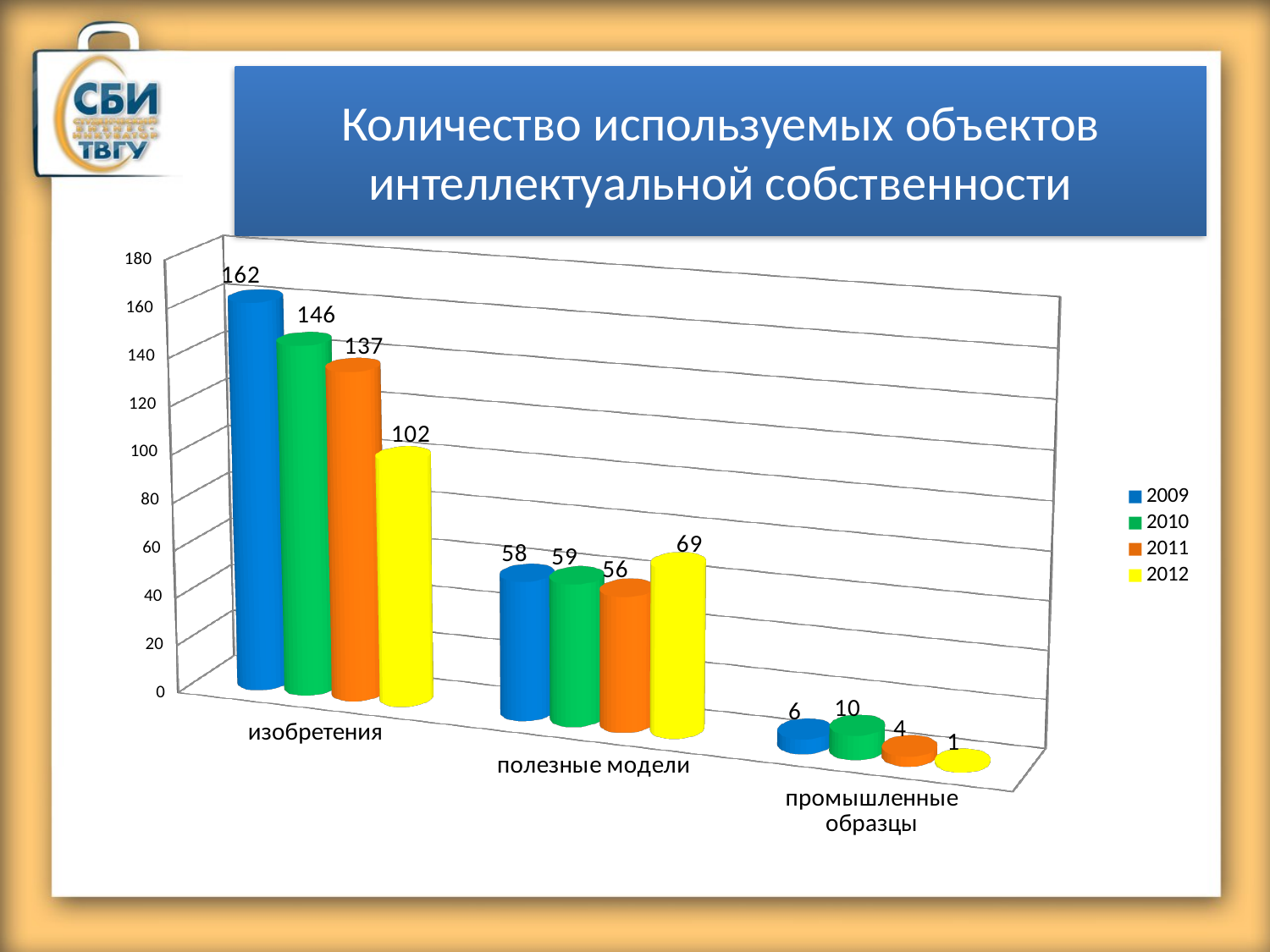
Which is larger for полезные модели: the 2010 value or the 2011 value? 2010 Which year has the highest value for изобретения? 2009 What is the value for изобретения in 2009? 162 What is the title of the chart? Количество используемых объектов интеллектуальной собственности What is the value for полезные модели in 2012? 69 What kind of chart is shown on the slide? bar chart What is the difference between the 2009 and 2012 values for изобретения? 60 Which year has the lowest value for промышленные образцы? 2012 What is the value for промышленные образцы in 2011? 4 How many categories are shown on the x axis? 3 How many series does the legend list? 4 Is the value for изобретения in 2011 greater or less than 120? greater